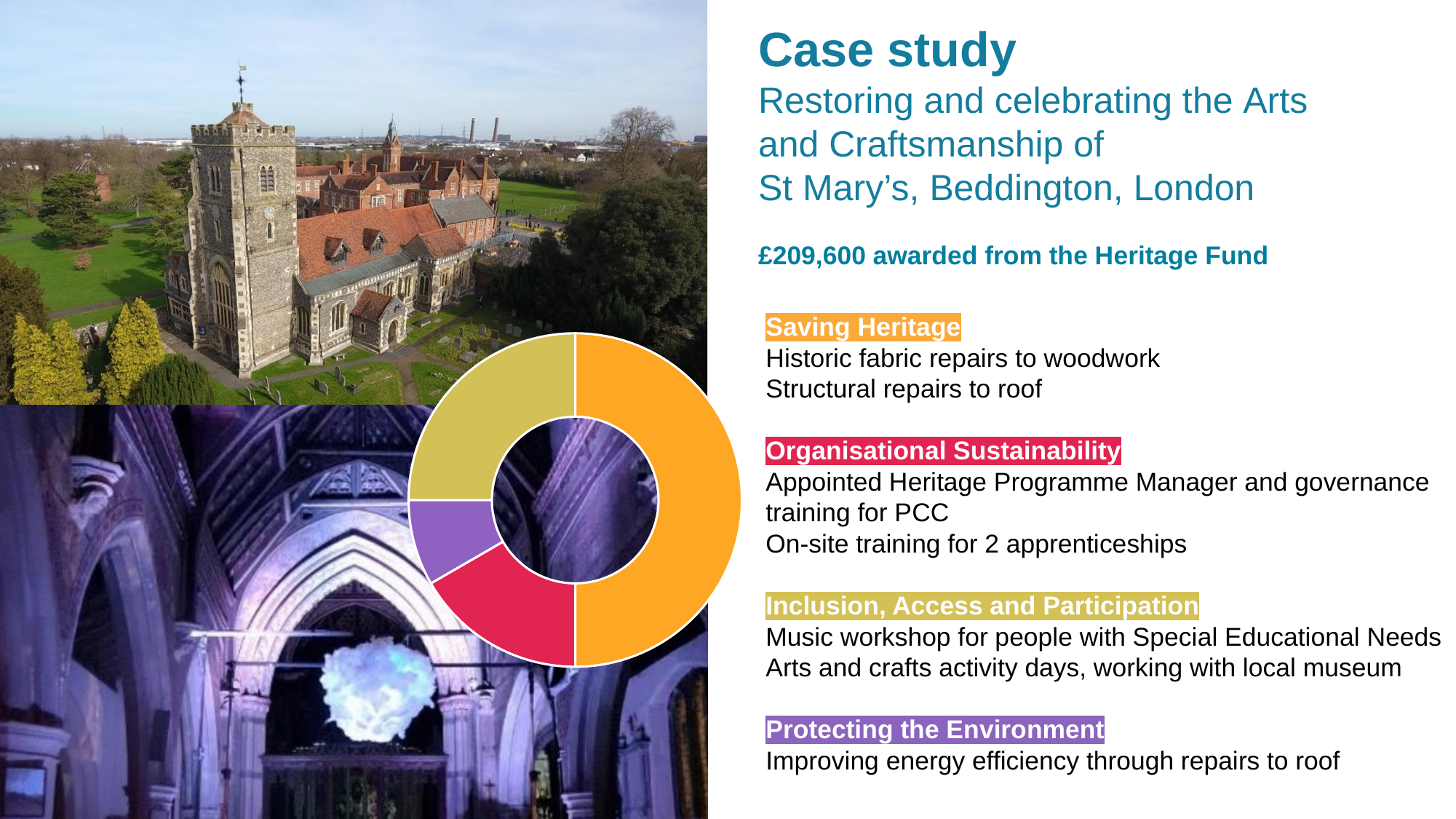
Which segment is larger in the doughnut chart: Inclusion, Access and Participation or Organisational Sustainability? Inclusion, Access and Participation What colour is the largest segment of the doughnut chart? Orange Which category takes up the smallest segment of the doughnut chart? Protecting the Environment Which category takes up the largest segment of the doughnut chart? Saving Heritage Which segment is larger in the doughnut chart: Organisational Sustainability or Protecting the Environment? Organisational Sustainability What kind of chart is shown on the slide? Doughnut (pie) chart Which segment is larger in the doughnut chart: Saving Heritage or Organisational Sustainability? Saving Heritage What colour is the segment representing Protecting the Environment in the doughnut chart? Purple How many segments does the doughnut chart have? 4